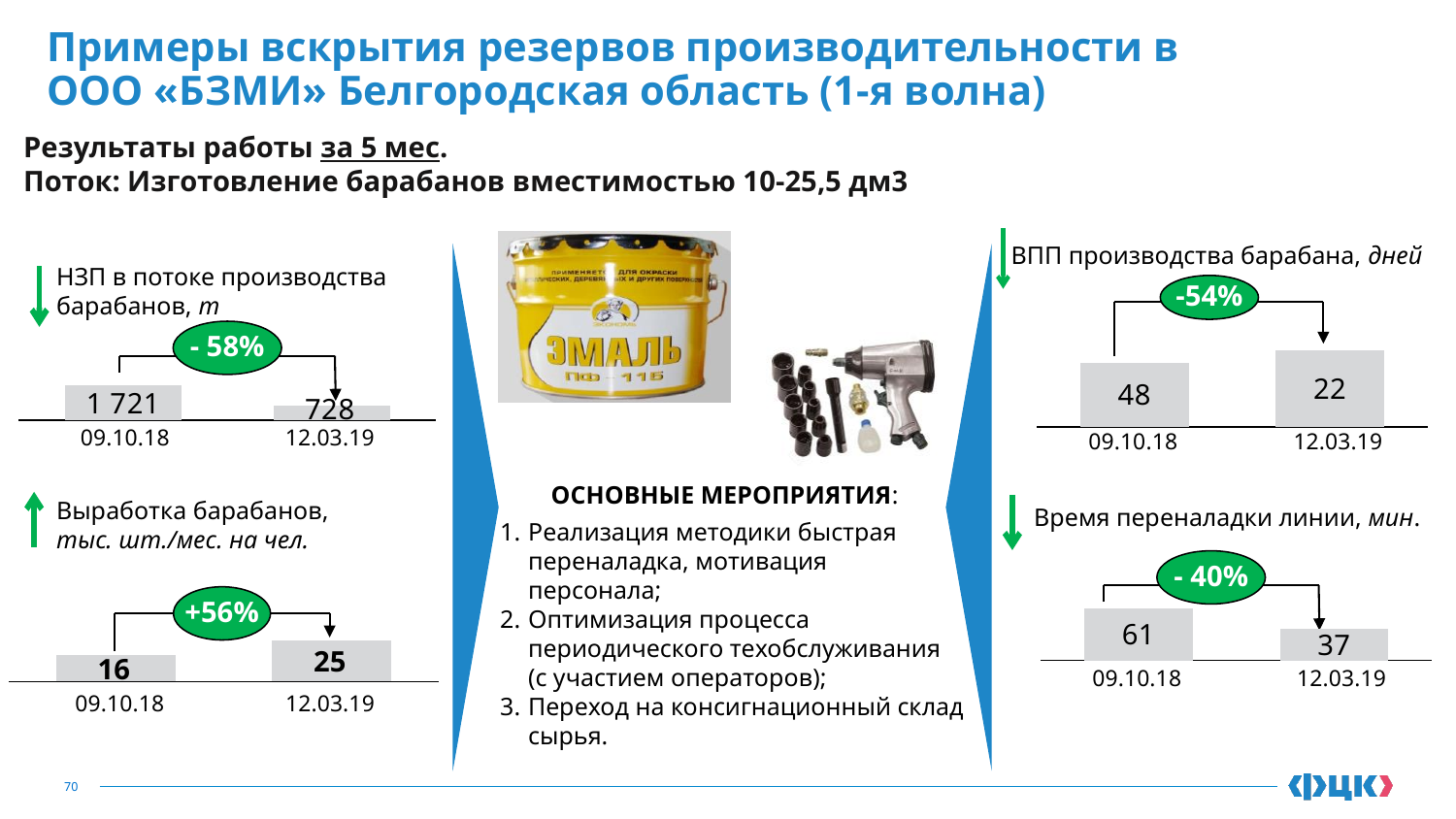
In the chart 'ВПП производства барабана, дней', what is the difference between the 09.10.18 and 12.03.19 values? 26 In the chart 'НЗП в потоке производства барабанов, т', what is the value for 09.10.18? 1 721 In the chart 'Выработка барабанов, тыс. шт./мес. на чел.', what is the difference between the 12.03.19 and 09.10.18 values? 9 In the chart 'Время переналадки линии, мин.', what percentage change is shown between the two dates? - 40% In the chart 'НЗП в потоке производства барабанов, т', what is the value for 12.03.19? 728 In the chart 'Выработка барабанов, тыс. шт./мес. на чел.', what is the value for 12.03.19? 25 In the chart 'Время переналадки линии, мин.', what is the value for 12.03.19? 37 In the chart 'ВПП производства барабана, дней', which date has the lower value? 12.03.19 What kind of chart is 'НЗП в потоке производства барабанов, т'? bar chart How many categories (dates) are shown in the chart 'Время переналадки линии, мин.'? 2 In the chart 'ВПП производства барабана, дней', what is the value for 09.10.18? 48 In the chart 'Выработка барабанов, тыс. шт./мес. на чел.', do values rise or fall from 09.10.18 to 12.03.19? rise